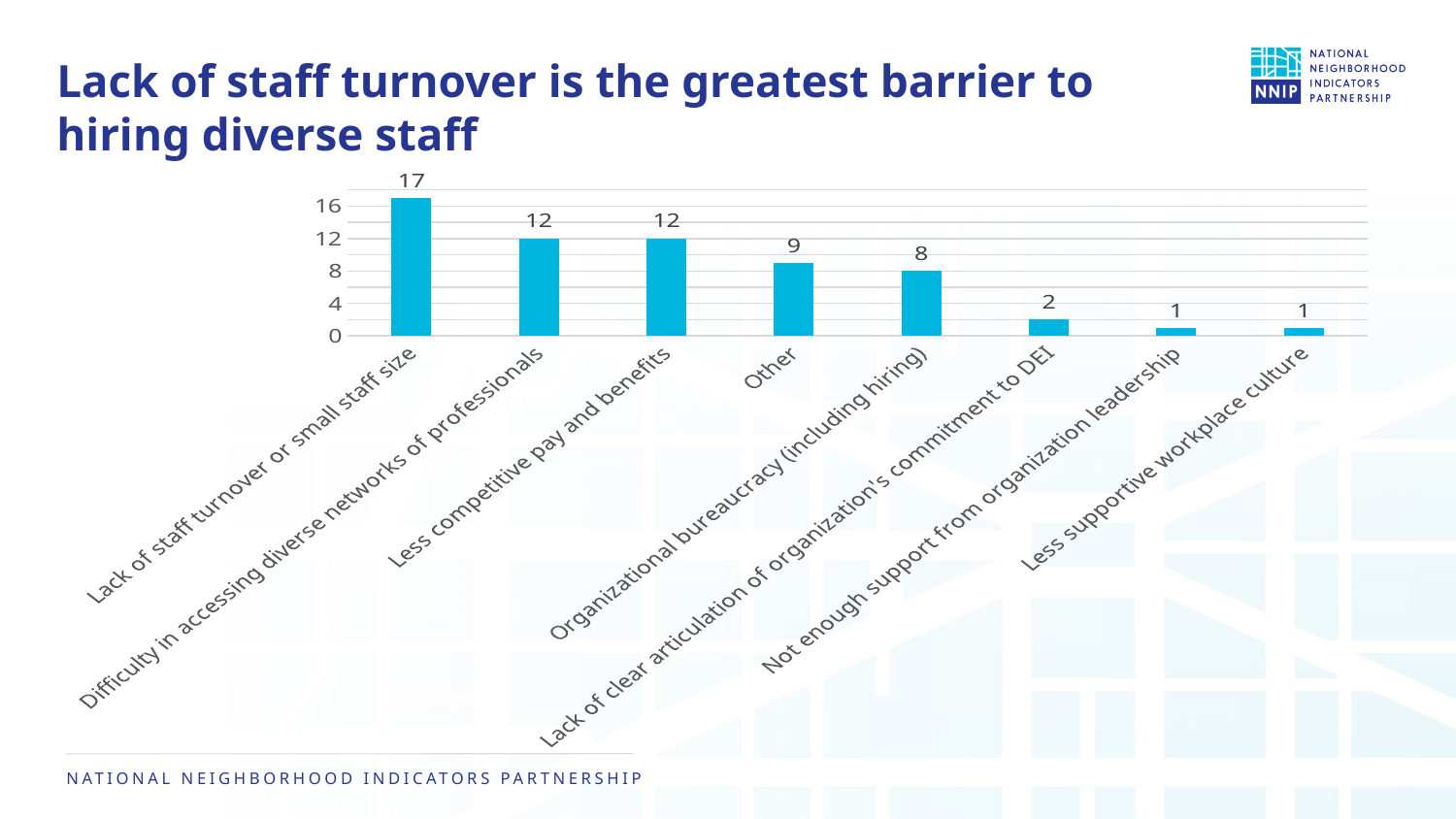
Which category has the highest value? Lack of staff turnover or small staff size What is the difference between the values for "Lack of staff turnover or small staff size" and "Difficulty in accessing diverse networks of professionals"? 5 What is the value for "Other"? 9 Do the values rise or fall moving from left to right along the x axis? Fall What is the value for "Less competitive pay and benefits"? 12 What is the value for "Organizational bureaucracy (including hiring)"? 8 What is the difference between the values for "Other" and "Organizational bureaucracy (including hiring)"? 1 How many categories are shown in the chart? 8 What kind of chart is shown on the slide? Bar chart What is the value for "Lack of staff turnover or small staff size"? 17 What is the value for "Lack of clear articulation of organization's commitment to DEI"? 2 Which is larger, the value for "Other" or the value for "Lack of clear articulation of organization's commitment to DEI"? Other